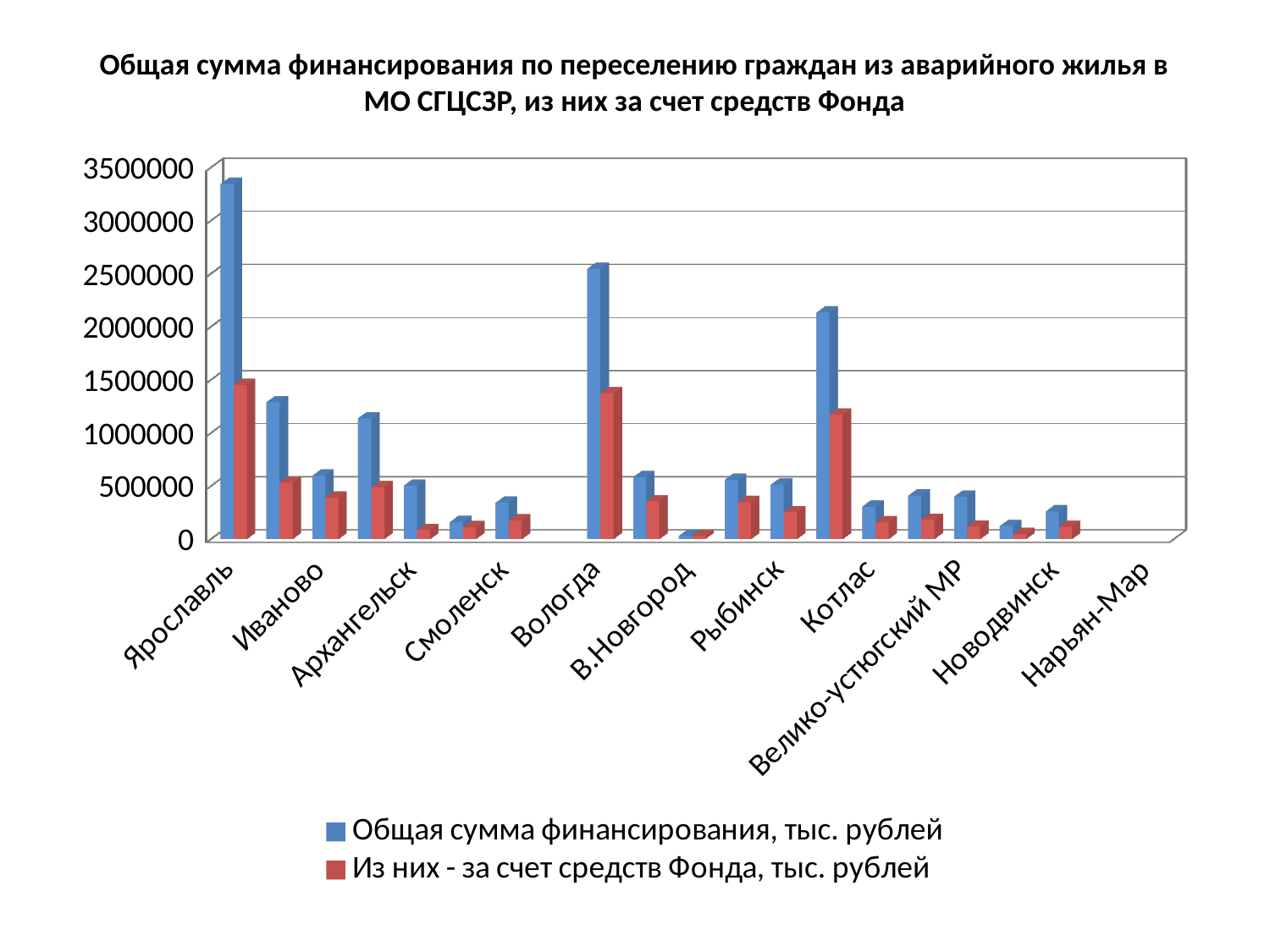
Is the value for Ярославль in the series 'Из них - за счет средств Фонда, тыс. рублей' greater or less than 1000000? greater Which category has the highest value for 'Общая сумма финансирования, тыс. рублей'? Ярославль Is the value for Вологда in the series 'Общая сумма финансирования, тыс. рублей' greater or less than 2000000? greater How many series does the legend list? 2 What colour are the bars for the series 'Из них - за счет средств Фонда, тыс. рублей'? red How many category labels are shown on the x axis? 11 Which is larger for Ярославль: 'Общая сумма финансирования, тыс. рублей' or 'Из них - за счет средств Фонда, тыс. рублей'? Общая сумма финансирования, тыс. рублей What kind of chart is shown on the slide? bar chart Is the value for Ярославль in the series 'Общая сумма финансирования, тыс. рублей' greater or less than 3000000? greater What is the first series listed in the legend? Общая сумма финансирования, тыс. рублей Which has the larger value for 'Общая сумма финансирования, тыс. рублей': Ярославль or Вологда? Ярославль